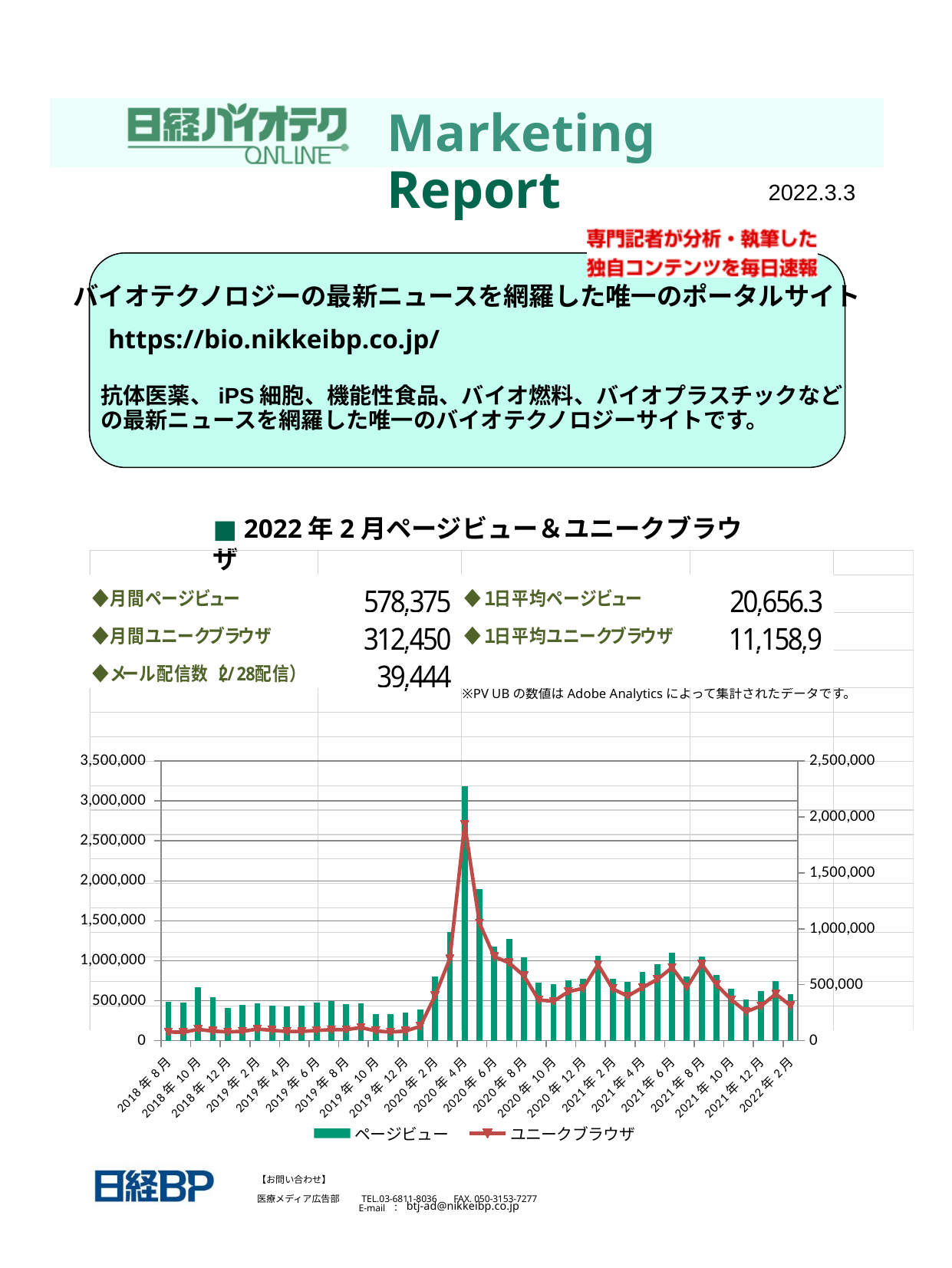
Is the page view value for 2018年8月 greater or less than 1,000,000? less Is the unique browser value for 2018年8月 greater or less than 500,000 on the right axis? less Which month has more page views, 2020年4月 or 2021年2月? 2020年4月 How many series does the chart legend list? 2 What is the maximum value shown on the left vertical axis of the chart? 3,500,000 Is the unique browser value for 2020年4月 greater or less than 1,500,000 on the right axis? greater In which month do unique browsers (ユニークブラウザ) reach their highest value? 2020年4月 Which two series are listed in the chart legend? ページビュー and ユニークブラウザ Do page views rise or fall from 2020年4月 to 2020年8月? fall What kind of chart is shown on the slide? A combined bar and line chart In which month do page views (ページビュー) reach their highest value? 2020年4月